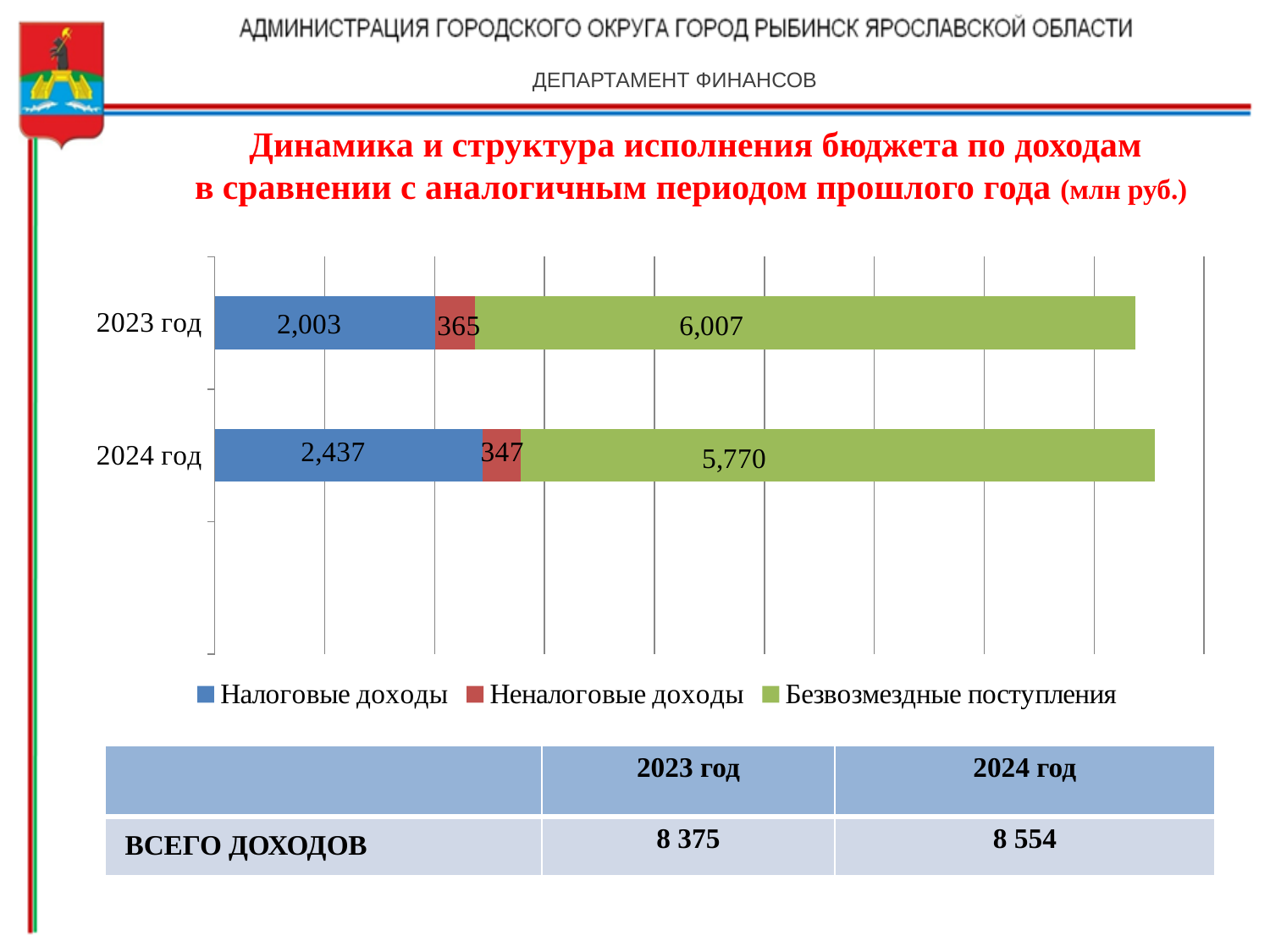
What is the value of Неналоговые доходы for 2024 год? 347 How many categories (years) are shown in the chart? 2 Which year has the higher value for Безвозмездные поступления, 2023 год or 2024 год? 2023 год What is the difference between Безвозмездные поступления in 2023 год and 2024 год? 237 What is the total of the stacked bar for 2024 год? 8,554 What is the value of Безвозмездные поступления for 2023 год? 6,007 What is the difference between Налоговые доходы in 2024 год and 2023 год? 434 What is the value of Налоговые доходы for 2023 год? 2,003 What is the value of Безвозмездные поступления for 2024 год? 5,770 Which year has the higher value for Налоговые доходы, 2023 год or 2024 год? 2024 год What kind of chart is shown on the slide? Stacked bar chart How many series does the legend list? 3